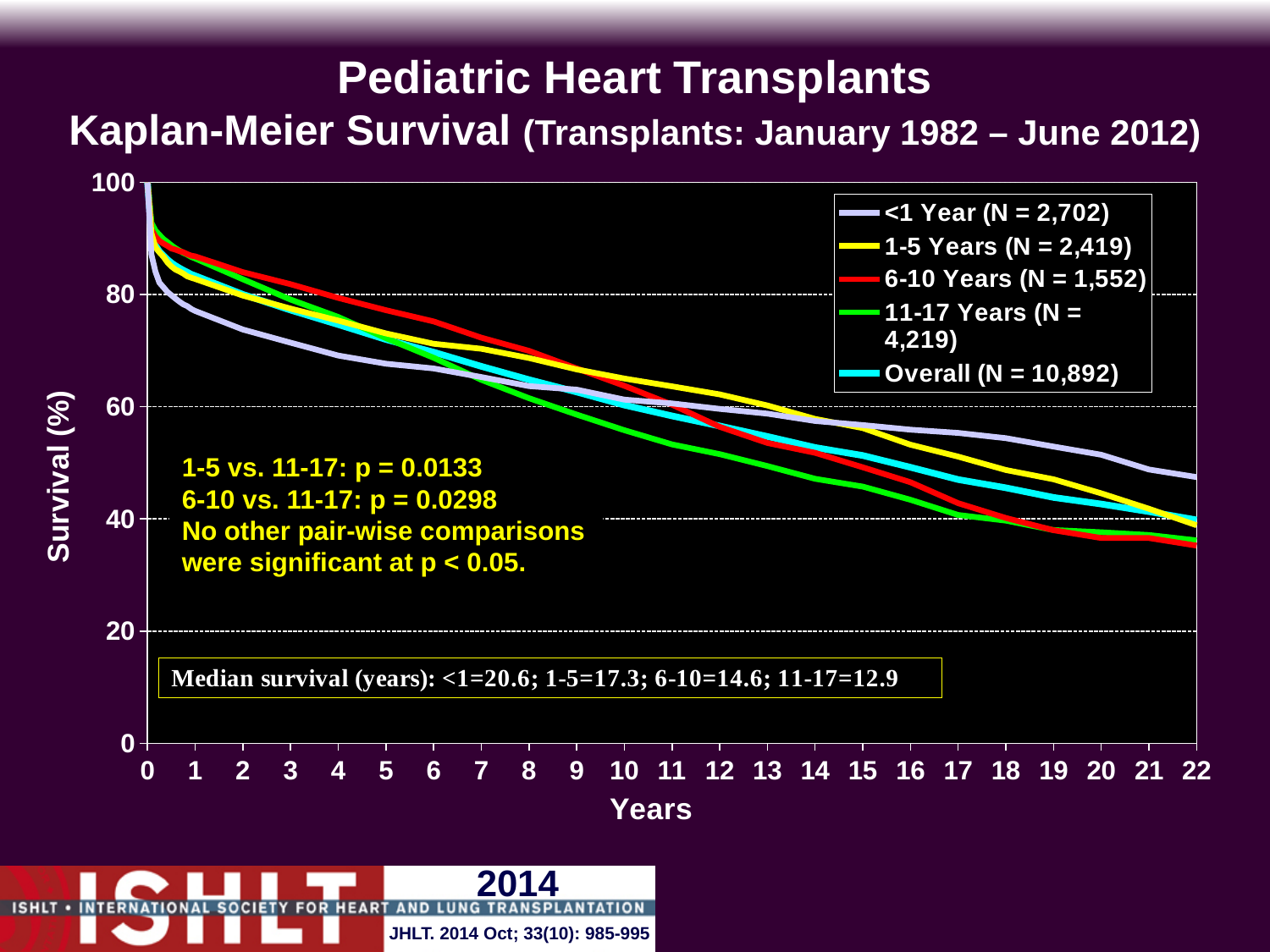
At 22 years, which group has higher survival, <1 Year or 6-10 Years? <1 Year What is the difference in median survival (years) between the <1 year group and the 11-17 years group? 7.7 Do the survival curves rise or fall as years increase? Fall What is the median survival in years for the 6-10 years group? 14.6 Which age group has the lowest median survival? 11-17 years How many series does the legend list? 5 What is the median survival in years for the <1 year group? 20.6 What is the p-value for the 1-5 vs. 11-17 comparison? 0.0133 What is the N for the Overall group shown in the legend? 10,892 At 22 years, is the survival for the <1 Year group greater or less than 40%? greater What kind of chart is shown on the slide? Line chart Which age group has the highest median survival? <1 year